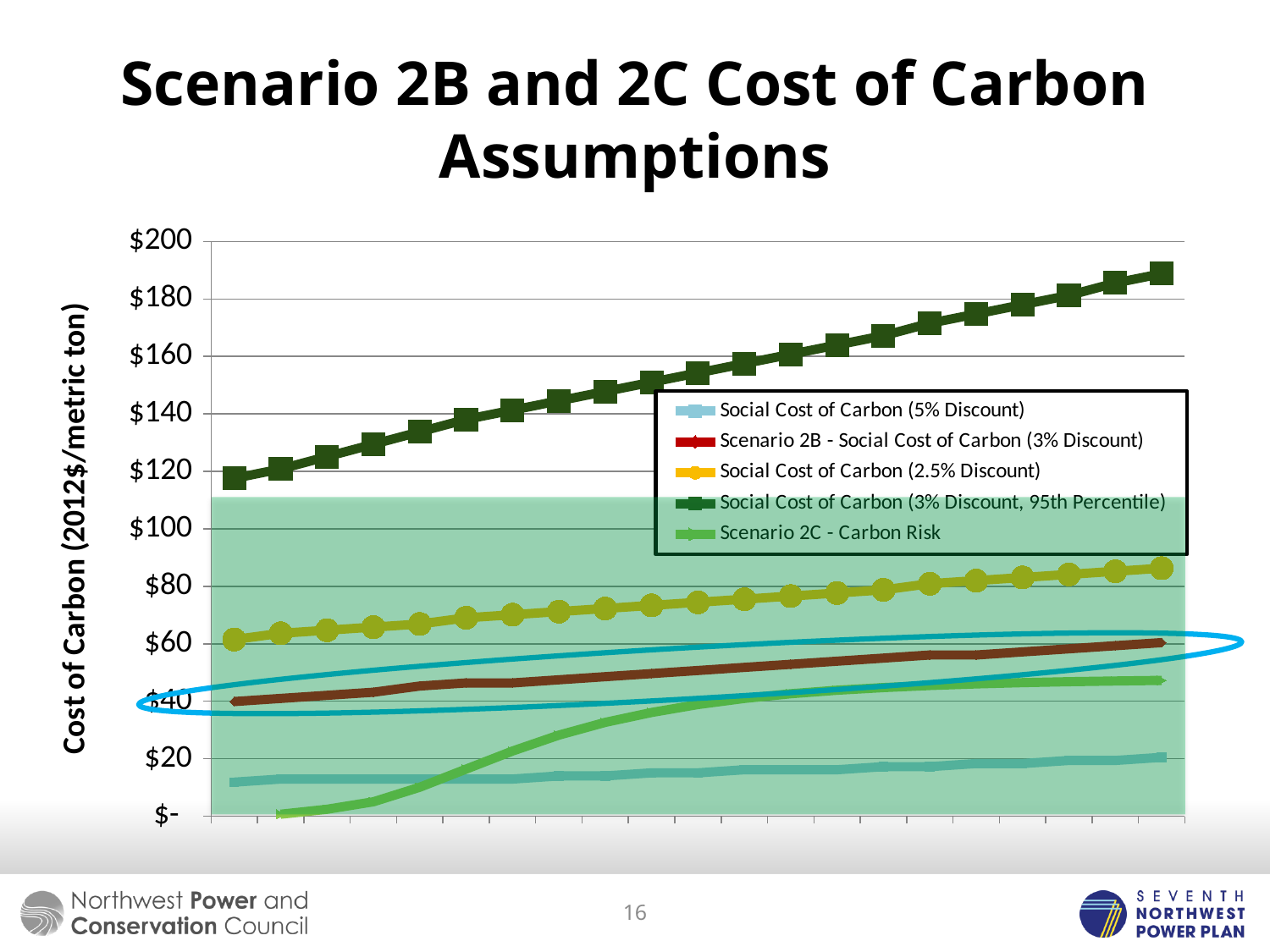
Is the last value of the Scenario 2B - Social Cost of Carbon (3% Discount) series greater or less than $80? less Is the first value of the Social Cost of Carbon (2.5% Discount) series greater or less than $80? less At the right end of the chart, which is larger: Scenario 2B - Social Cost of Carbon (3% Discount) or Scenario 2C - Carbon Risk? Scenario 2B - Social Cost of Carbon (3% Discount) How many series does the legend list? 5 Is the last value of the Social Cost of Carbon (3% Discount, 95th Percentile) series greater or less than $180? greater What kind of chart is shown on the slide? line chart Do the values of the Social Cost of Carbon (3% Discount, 95th Percentile) series rise or fall along the x axis? rise What is the label on the vertical axis of the chart? Cost of Carbon (2012$/metric ton) Which series has the highest values across the chart? Social Cost of Carbon (3% Discount, 95th Percentile)